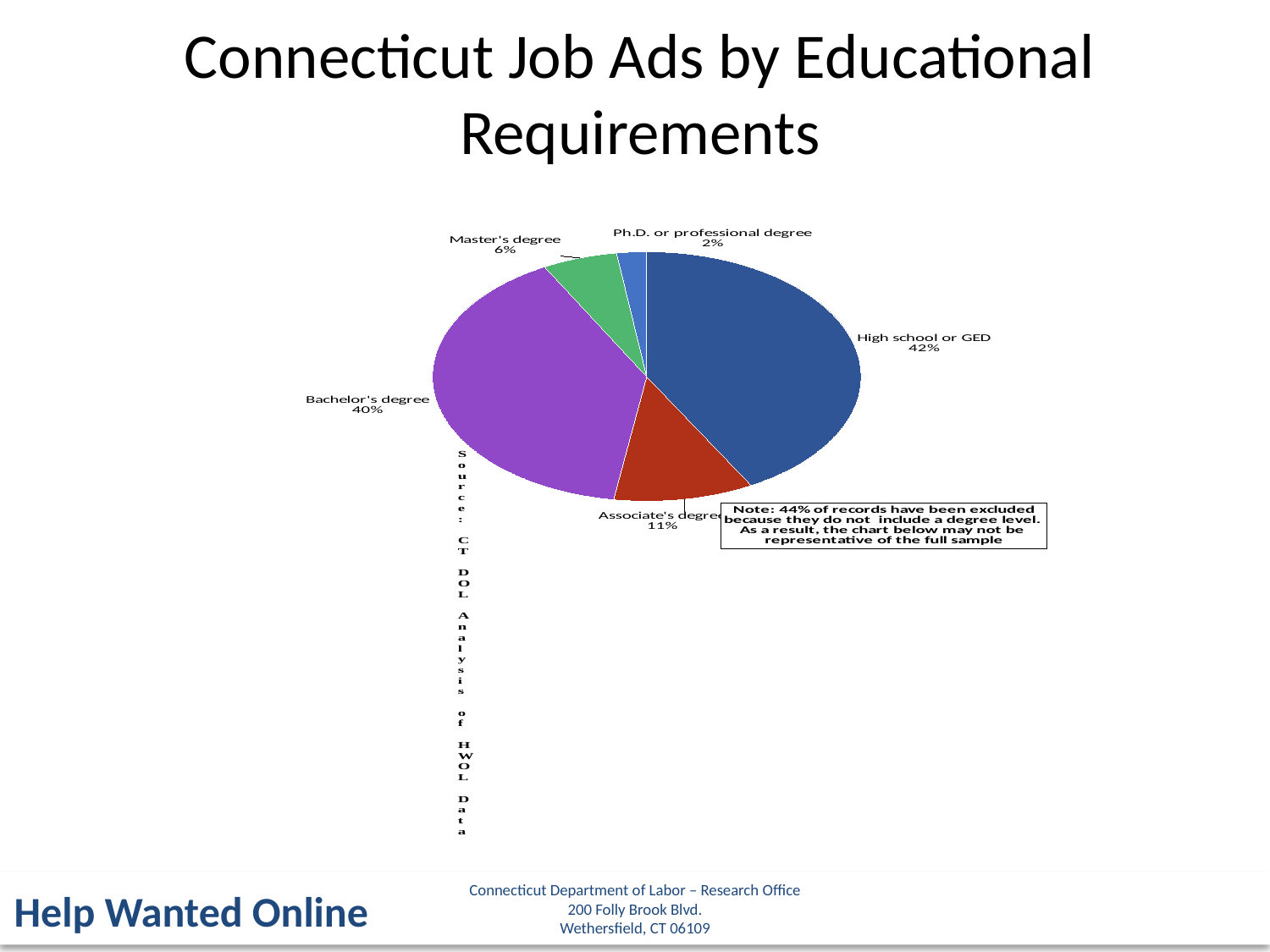
What share of job ads require a Ph.D. or professional degree? 2% What share of Connecticut job ads require a high school diploma or GED? 42% What share of job ads require an Associate's degree? 11% What is the title of the chart on the slide? Connecticut Job Ads by Educational Requirements What kind of chart is shown on the slide? pie chart Which is larger, the share for Master's degree or the share for Associate's degree? Associate's degree What is the difference in percentage points between the Bachelor's degree share and the Associate's degree share? 29 How many educational requirement categories are shown in the pie chart? 5 Which educational requirement has the smallest share of job ads? Ph.D. or professional degree Which educational requirement has the largest share of job ads? High school or GED